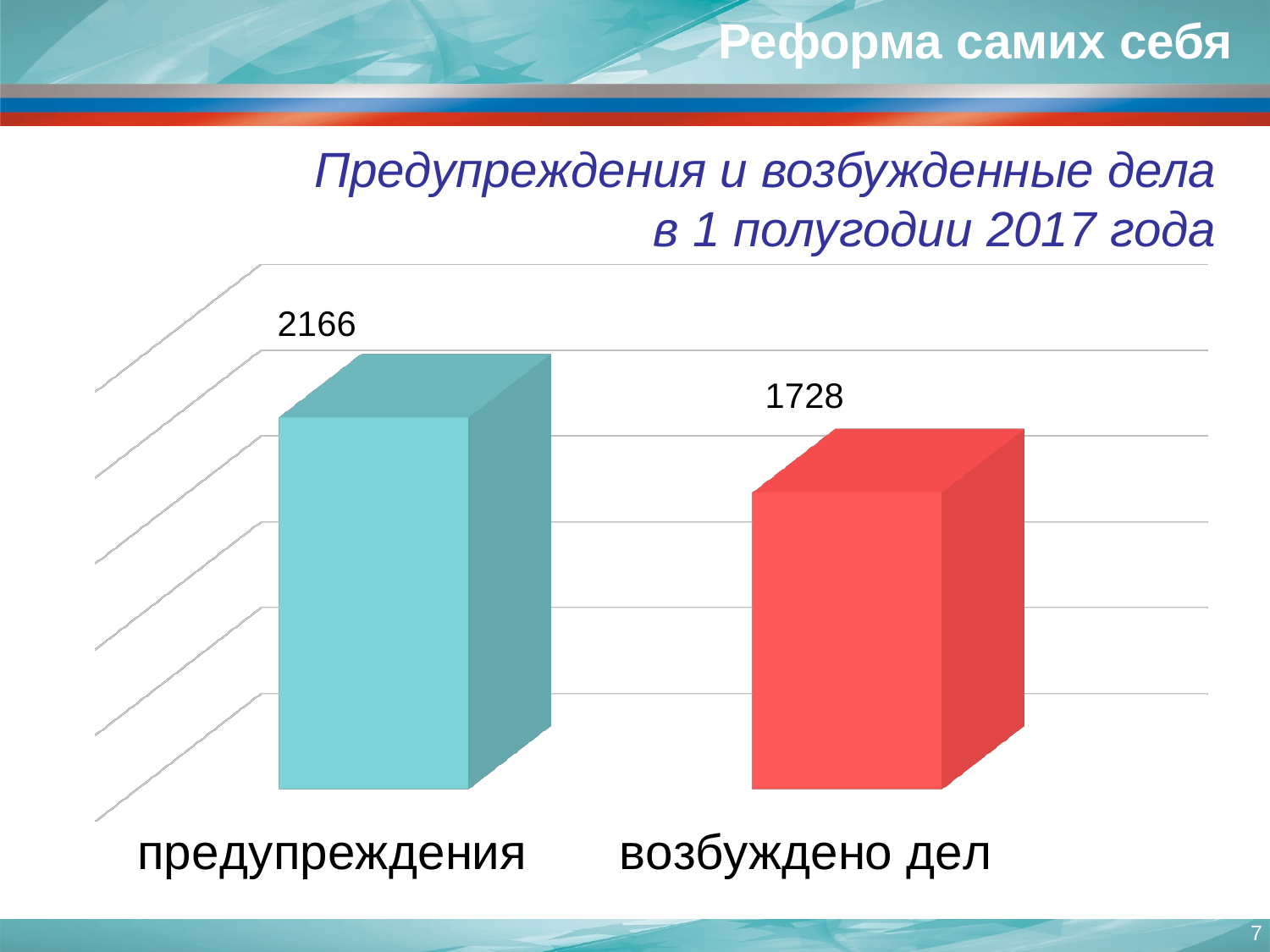
What is the value for предупреждения? 2166 What is the title of the chart? Предупреждения и возбужденные дела в 1 полугодии 2017 года Which is larger, the value for предупреждения or the value for возбуждено дел? предупреждения What kind of chart is shown on the slide? bar chart What is the difference between the values for предупреждения and возбуждено дел? 438 How many categories are shown in the chart? 2 Which category has the lowest value? возбуждено дел What is the value for возбуждено дел? 1728 Which category has the highest value? предупреждения What colour is the bar for возбуждено дел? red